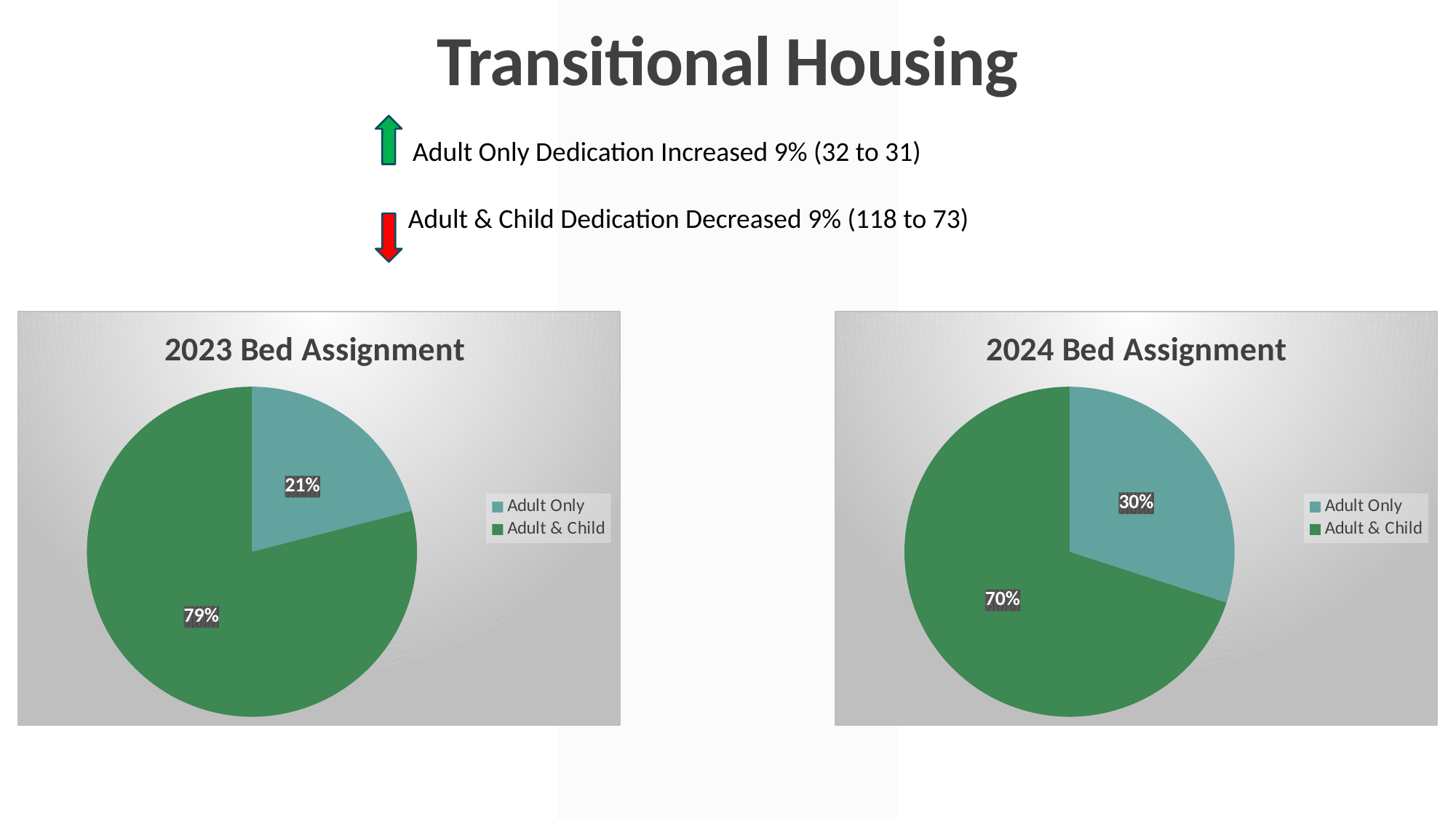
In the 2023 Bed Assignment chart, which category has the largest slice? Adult & Child How many categories does the 2023 Bed Assignment chart show? 2 In the 2024 Bed Assignment chart, what is the difference between the Adult & Child share and the Adult Only share? 40% In the 2024 Bed Assignment chart, what share of the pie is Adult & Child? 70% In the 2024 Bed Assignment chart, what share of the pie is Adult Only? 30% What kind of chart is the 2024 Bed Assignment chart? Pie chart Is the Adult Only share larger in the 2023 Bed Assignment chart or the 2024 Bed Assignment chart? 2024 Bed Assignment What entries does the legend of the 2024 Bed Assignment chart list? Adult Only, Adult & Child In the 2023 Bed Assignment chart, what share of the pie is Adult & Child? 79% In the 2024 Bed Assignment chart, which category has the smallest slice? Adult Only In the 2023 Bed Assignment chart, what is the difference between the Adult & Child share and the Adult Only share? 58%